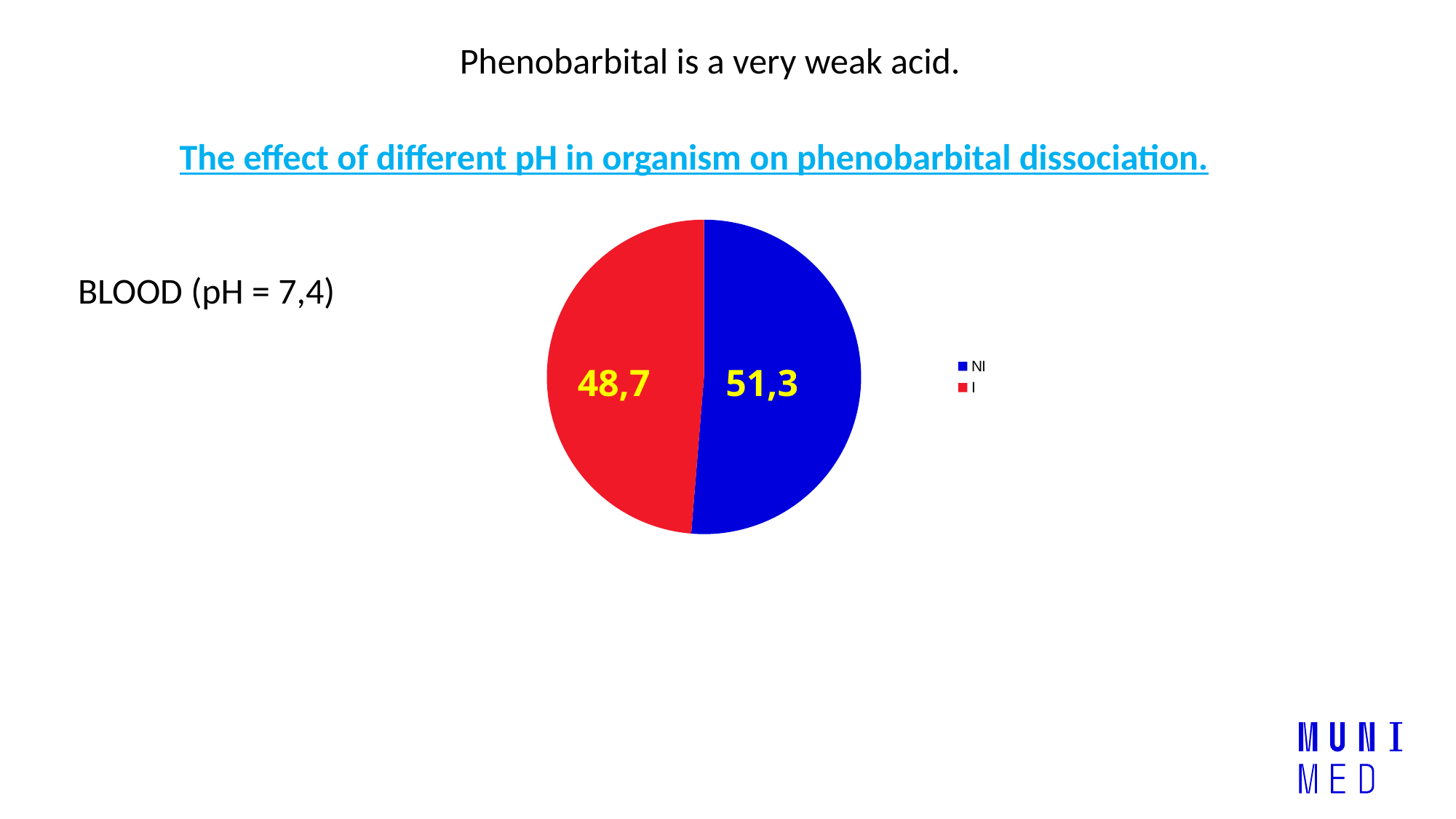
What kind of chart is shown on the slide? pie chart What colour is the NI slice in the pie chart? blue What is the value of the NI slice in the pie chart? 51,3 What is the value of the I slice in the pie chart? 48,7 What colour is the I slice in the pie chart? red How many entries does the legend of the pie chart list? 2 Which is larger in the pie chart, NI or I? NI How many slices does the pie chart have? 2 Which slice of the pie chart is the smallest? I Is the value of the I slice in the pie chart greater or less than 50? less What is the difference between the NI and I values in the pie chart? 2,6 Which slice of the pie chart is the largest? NI